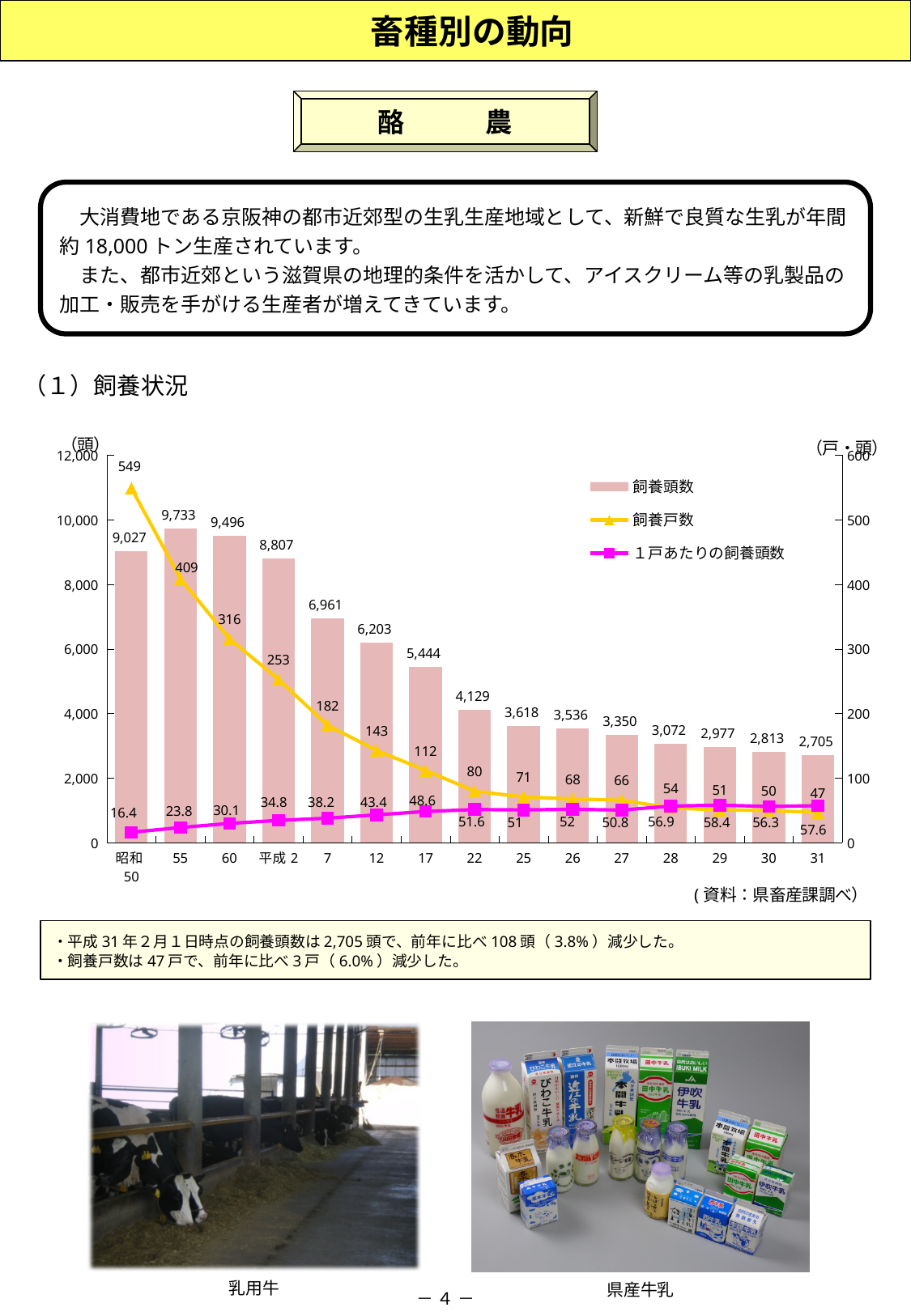
What is the 1戸あたりの飼養頭数 (head per household) for 平成29? 58.4 What is the 飼養戸数 (number of households) for 昭和50? 549 Is the 飼養頭数 for 平成7 greater or less than 6,000? greater In which year is the 飼養戸数 lowest? 31 (平成31) What is the 飼養頭数 (number of head) for 平成31? 2,705 How many series does the legend list? 3 In which year is the 飼養頭数 highest? 55 (昭和55) What is the difference in 飼養頭数 between 平成30 and 平成31? 108 How many years (categories) are shown on the x axis? 15 Which is larger, the 飼養頭数 for 平成25 or for 平成26? 平成25 What kind of chart is used to show the 飼養頭数 series? bar chart Does the 飼養戸数 series rise or fall from 昭和50 to 平成31? fall